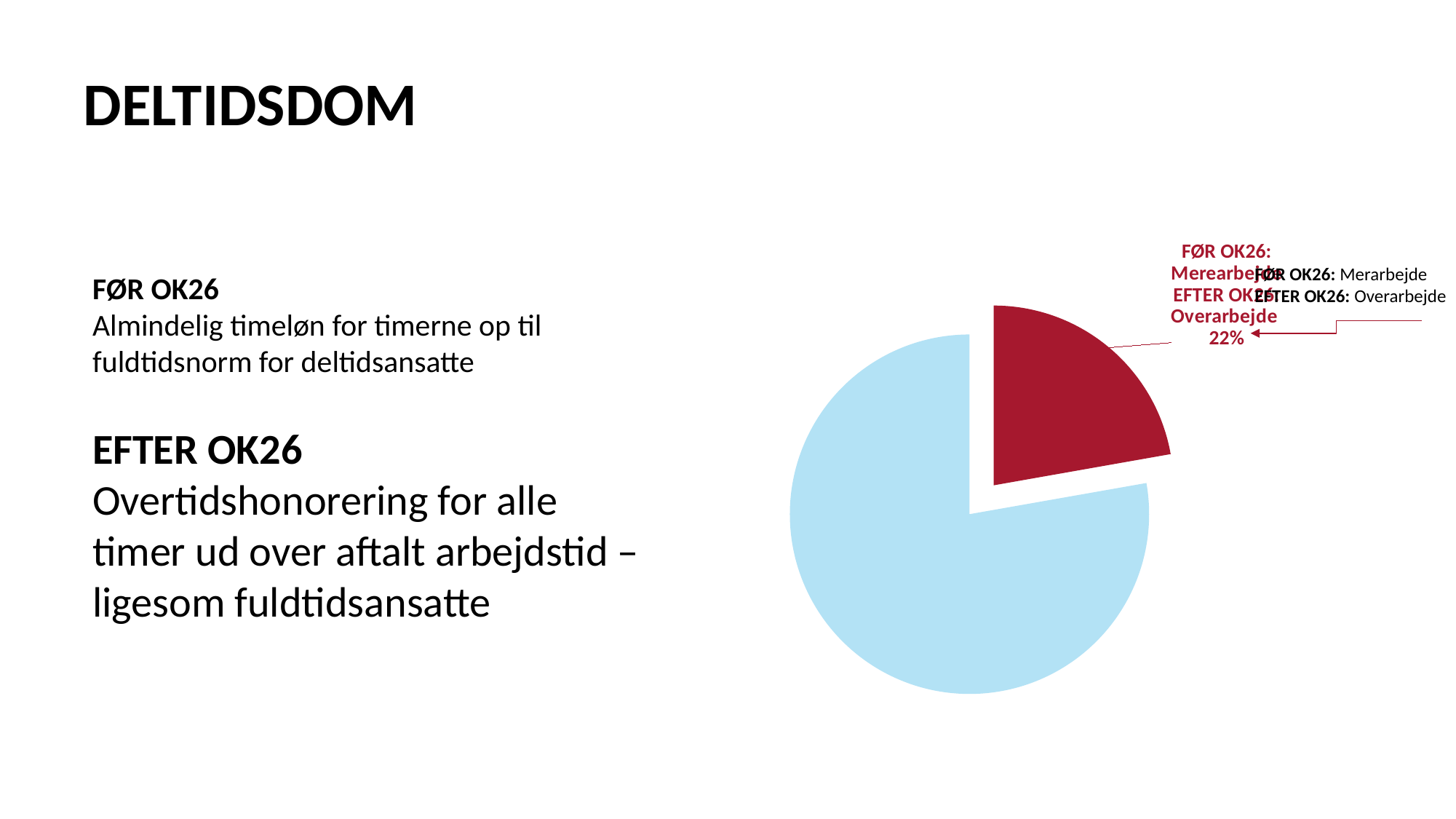
What percentage is printed on the dark red slice of the pie chart? 22% What kind of chart is shown on the slide? Pie chart What colour is the slice labelled 22% in the pie chart? Dark red How many slices does the pie chart have? 2 Which slice of the pie chart is the smallest? The dark red slice (FØR OK26: Merearbejde / EFTER OK26: Overarbejde) Which slice of the pie chart is the largest? The light blue slice What label is attached to the 22% slice of the pie chart? FØR OK26: Merearbejde EFTER OK26: Overarbejde Which slice of the pie chart is larger, the light blue slice or the dark red slice? The light blue slice